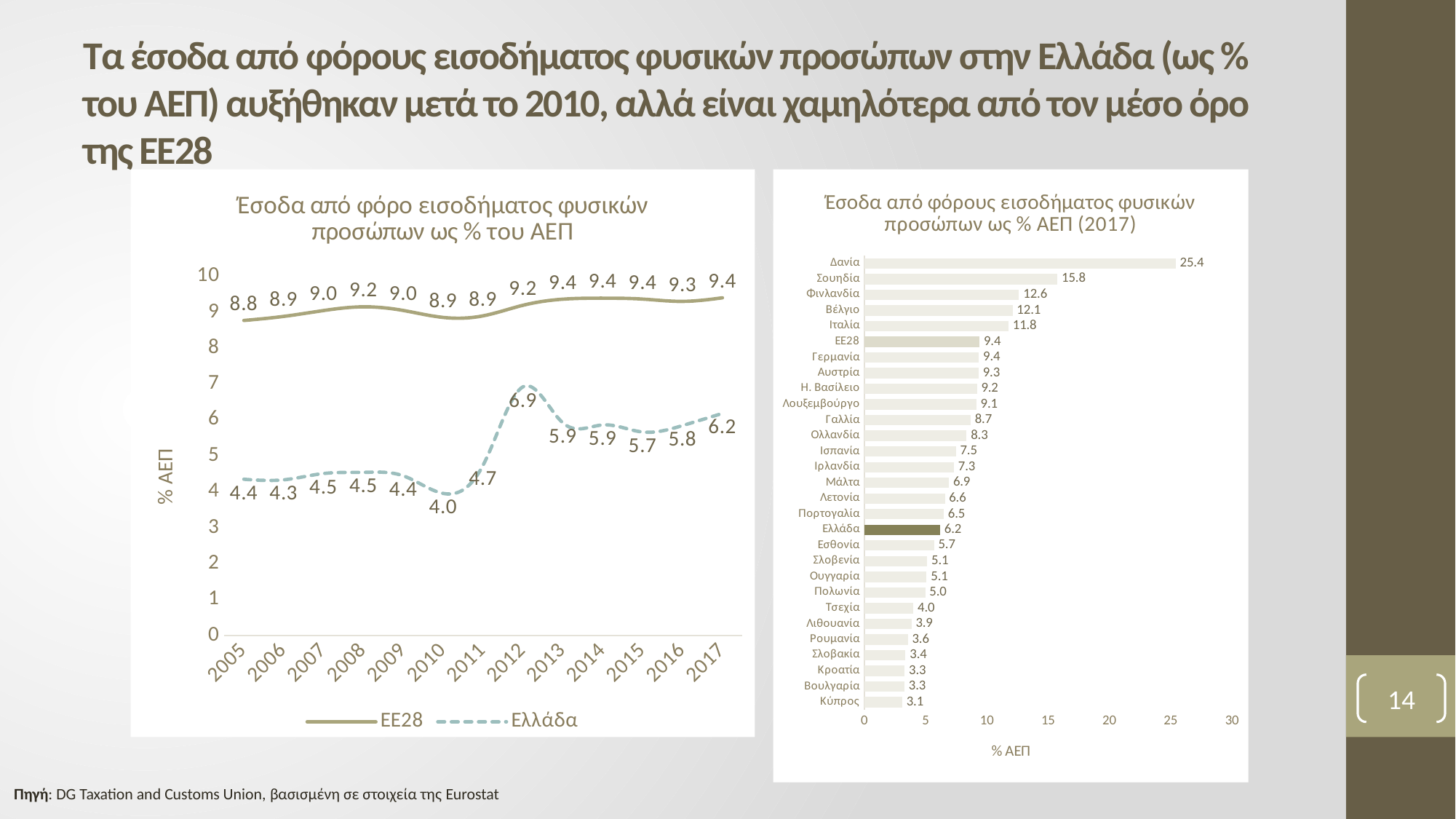
In the right chart, which country has the lowest value? Κύπρος In the right chart, which country has the highest value? Δανία In the left chart, what was the value for ΕΕ28 in 2005? 8.8 In the left chart, in which year was the Ελλάδα series at its lowest? 2010 In the right chart, what is the value for Σουηδία? 15.8 In the left chart, how many years are shown on the x axis? 13 What kind of chart is the left chart? Line chart What kind of chart is the right chart? Bar chart In the left chart, what was the value for Ελλάδα in 2012? 6.9 In the left chart, what is the difference between ΕΕ28 and Ελλάδα in 2017? 3.2 In the right chart, which is larger, the value for Ισπανία or the value for Πορτογαλία? Ισπανία In the left chart, how many series does the legend list? 2